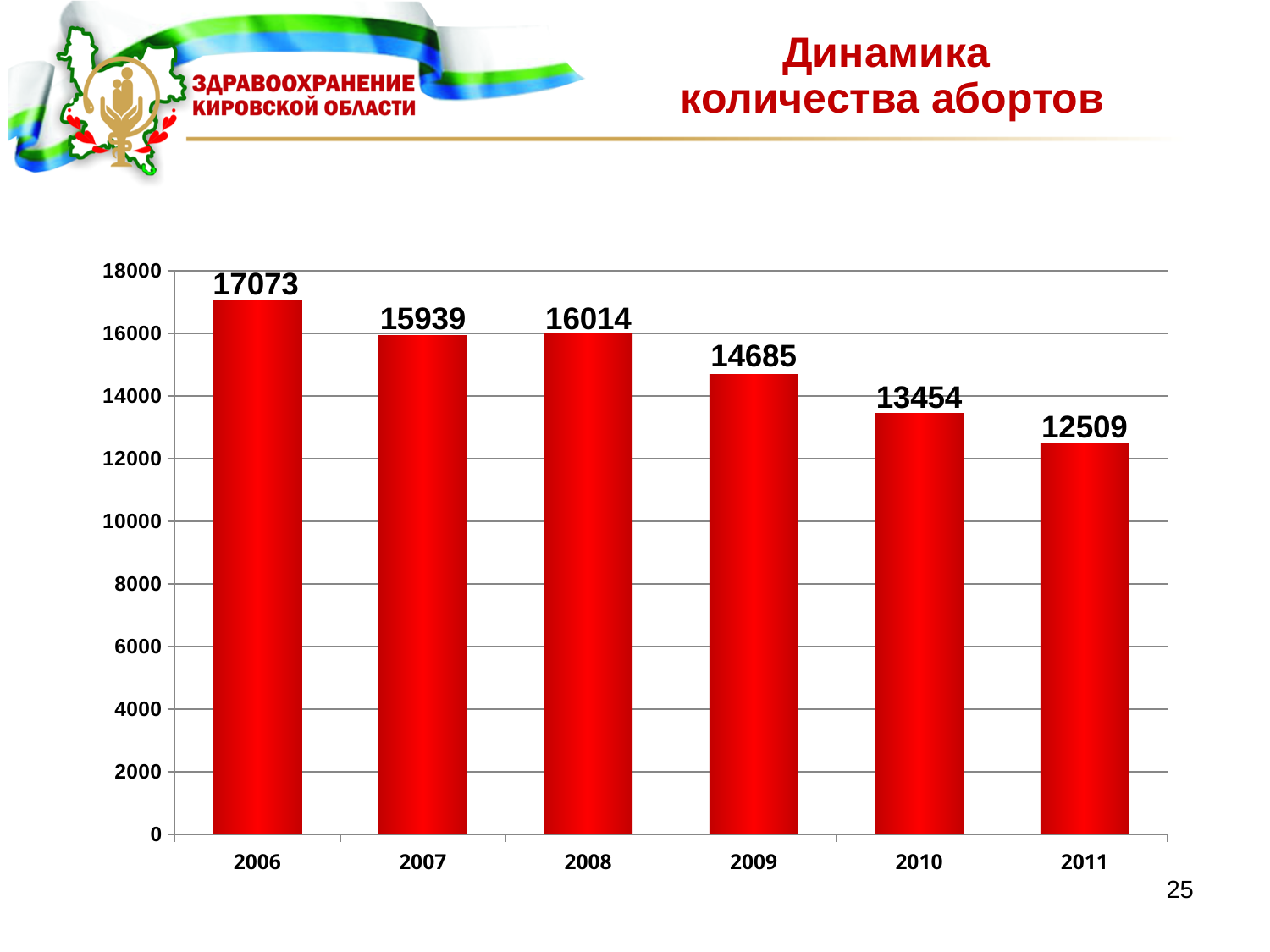
Which year has the lowest value? 2011 What kind of chart is shown on the slide? bar chart Which is larger, the value for 2007 or the value for 2008? 2008 What is the difference between the values for 2009 and 2010? 1231 Which year has the highest value? 2006 What is the difference between the values for 2006 and 2011? 4564 How many years are shown on the x axis? 6 What is the value for 2011? 12509 What is the value for 2009? 14685 Is the value for 2010 greater or less than 14000? less What is the title of the chart? Динамика количества абортов What is the value for 2006? 17073